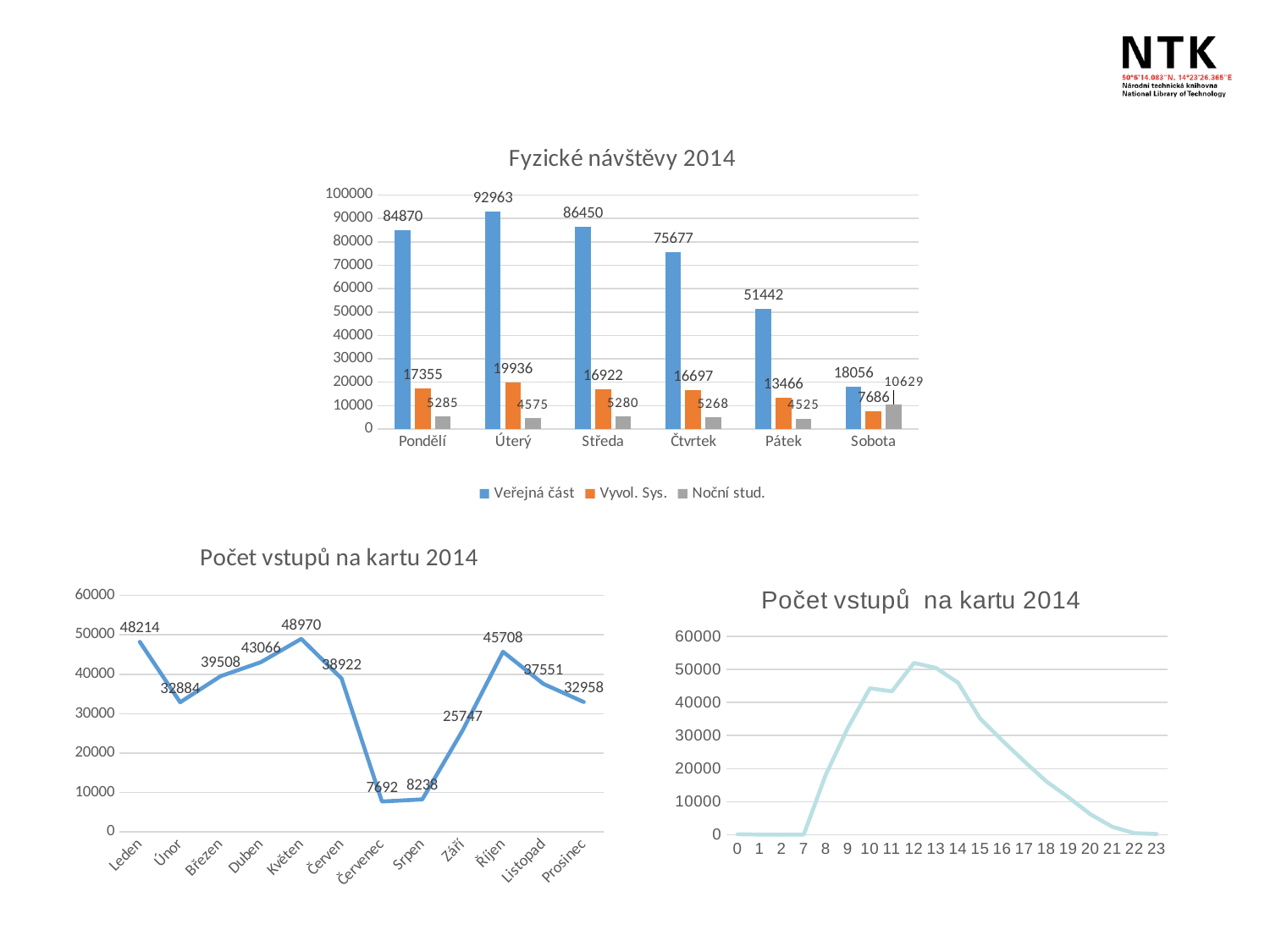
In the top chart (Fyzické návštěvy 2014), what is the difference between the Veřejná část values for Pondělí and Pátek? 33428 In the top chart (Fyzické návštěvy 2014), which day has the highest Veřejná část value? Úterý In the top chart (Fyzické návštěvy 2014), what is the value of Veřejná část for Úterý? 92963 In the top chart (Fyzické návštěvy 2014), which day has the lowest Vyvol. Sys. value? Sobota In the bottom-left chart (Počet vstupů na kartu 2014 by month), which month has the highest value? Květen What kind of chart is the top chart (Fyzické návštěvy 2014)? bar chart In the bottom-left chart (Počet vstupů na kartu 2014 by month), what is the value for Červenec? 7692 In the top chart (Fyzické návštěvy 2014), what is the value of Noční stud. for Sobota? 10629 In the bottom-right chart (Počet vstupů na kartu 2014 by hour), is the value at hour 15 greater or less than 40000? less In the bottom-right chart (Počet vstupů na kartu 2014 by hour), is the value at hour 10 greater or less than 40000? greater In the top chart (Fyzické návštěvy 2014), how many series does the legend list? 3 In the bottom-left chart (Počet vstupů na kartu 2014 by month), how many months are plotted? 12